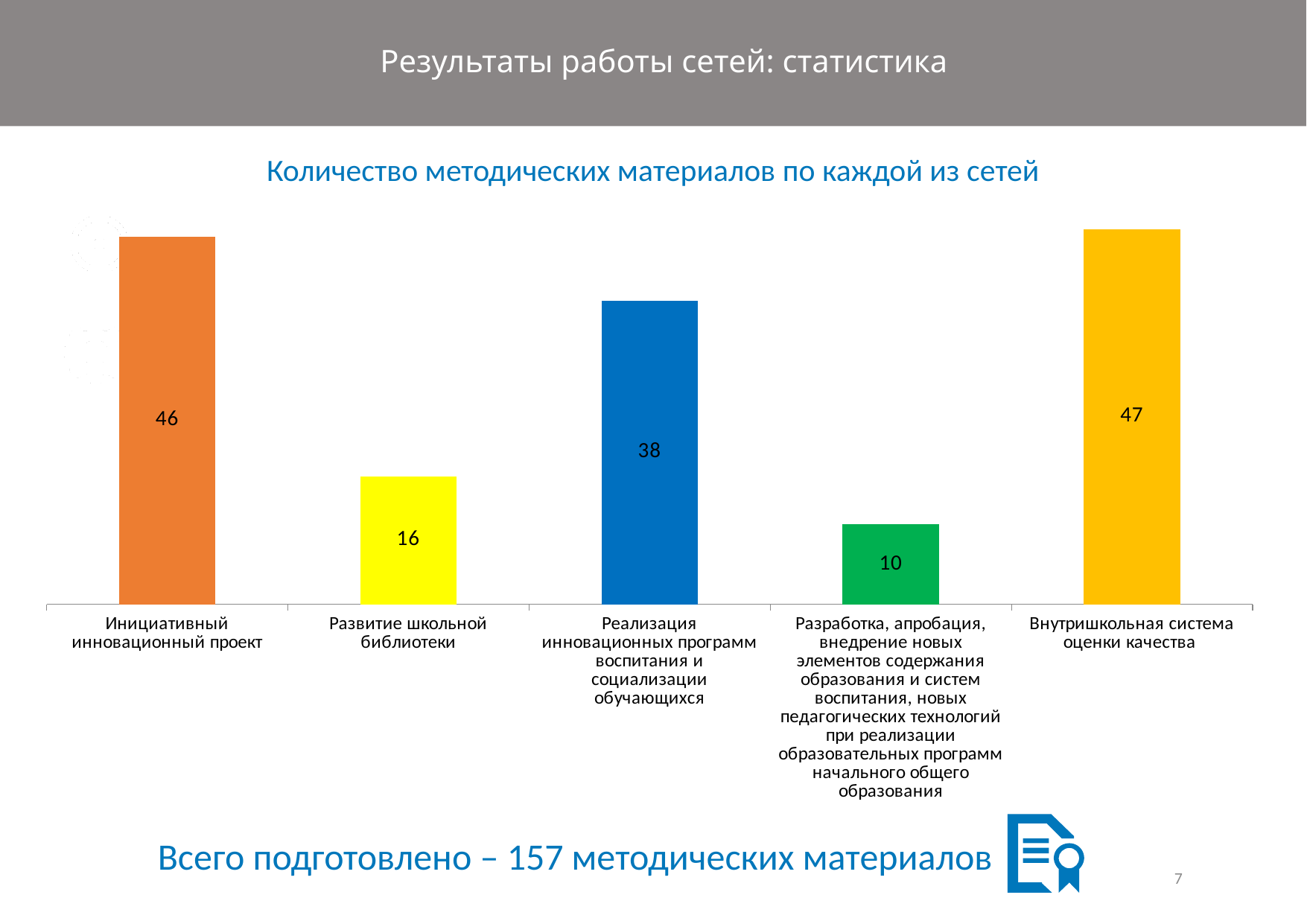
What is the value for «Инициативный инновационный проект»? 46 Which category has the lowest value? Разработка, апробация, внедрение новых элементов содержания образования и систем воспитания, новых педагогических технологий при реализации образовательных программ начального общего образования What is the difference between the values for «Инициативный инновационный проект» and «Развитие школьной библиотеки»? 30 What colour is the bar for «Реализация инновационных программ воспитания и социализации обучающихся»? Blue How many categories are shown in the chart? 5 What is the value for «Внутришкольная система оценки качества»? 47 What is the title of the chart? Количество методических материалов по каждой из сетей Which is larger: the value for «Реализация инновационных программ воспитания и социализации обучающихся» or for «Развитие школьной библиотеки»? Реализация инновационных программ воспитания и социализации обучающихся What is the difference between the values for «Реализация инновационных программ воспитания и социализации обучающихся» and the lowest category? 28 What kind of chart is shown on the slide? Bar chart What is the value for «Развитие школьной библиотеки»? 16 Which category has the highest value? Внутришкольная система оценки качества